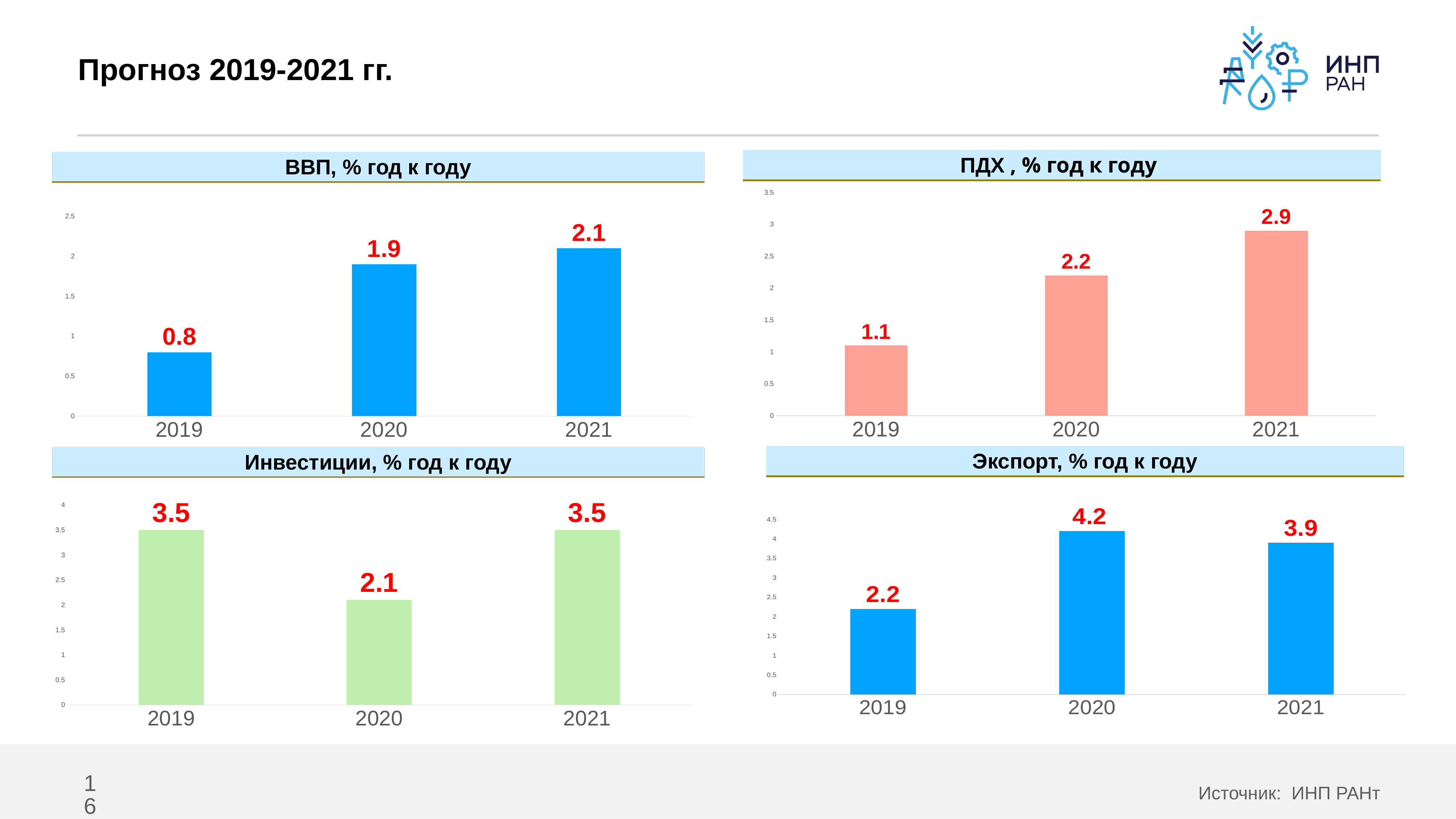
In the 'Экспорт, % год к году' chart, what is the difference between the 2020 and 2019 values? 2.0 In the 'Инвестиции, % год к году' chart, which year has the lowest value? 2020 In the 'ВВП, % год к году' chart, what is the value for 2020? 1.9 In the 'ВВП, % год к году' chart, which year has the lowest value? 2019 In the 'ПДХ , % год к году' chart, what is the difference between the 2021 and 2019 values? 1.8 In the 'ПДХ , % год к году' chart, do the values rise or fall from 2019 to 2021? rise In the 'ПДХ , % год к году' chart, what is the value for 2021? 2.9 What kind of chart is the 'Инвестиции, % год к году' chart? bar chart How many years are shown on the x axis of the 'ВВП, % год к году' chart? 3 In the 'Инвестиции, % год к году' chart, what is the value for 2020? 2.1 In the 'Экспорт, % год к году' chart, which is larger, the value for 2020 or the value for 2021? 2020 In the 'Экспорт, % год к году' chart, which year has the highest value? 2020